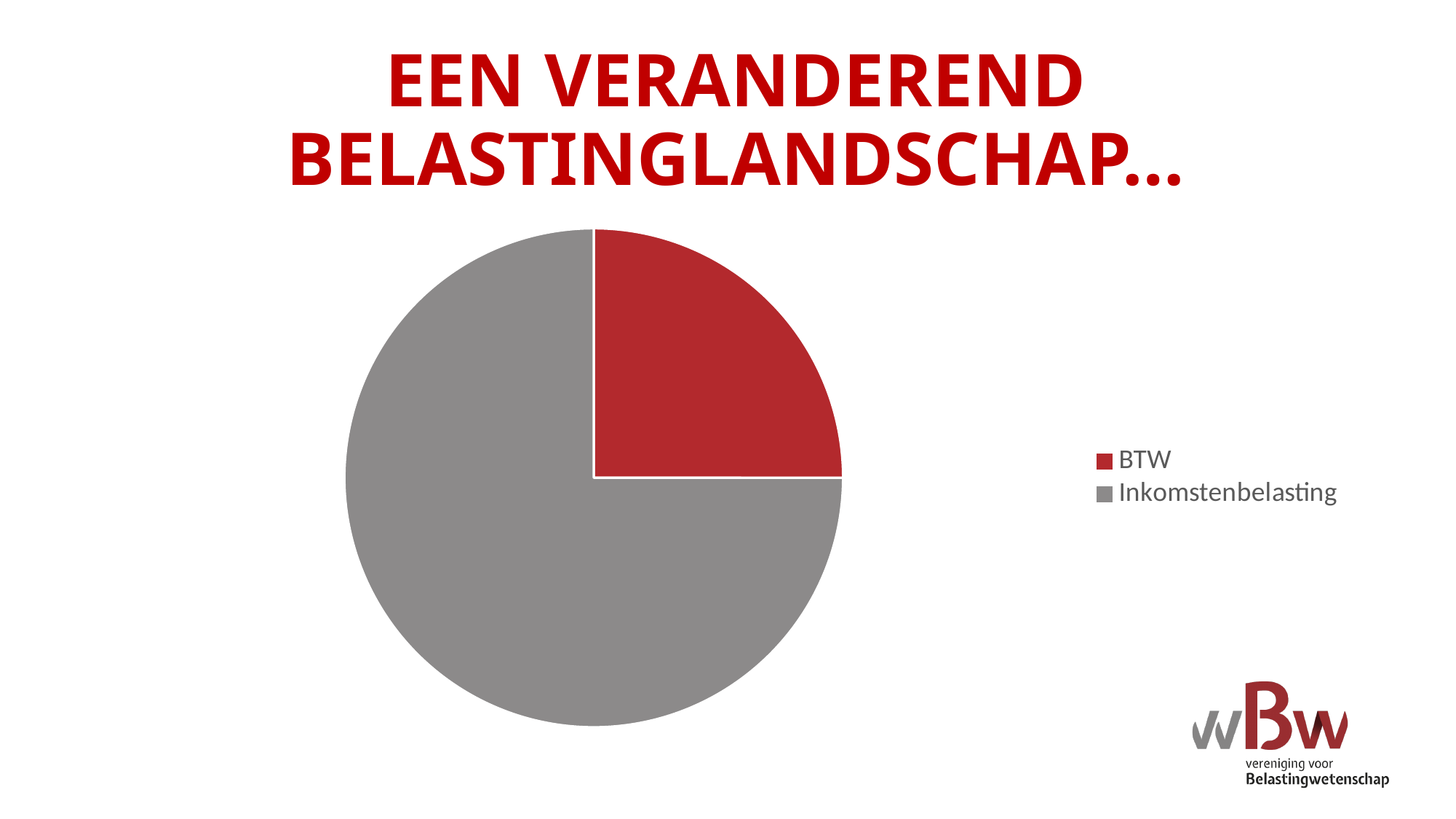
What colour is the BTW slice in the pie chart? red Which slice is larger in the pie chart, BTW or Inkomstenbelasting? Inkomstenbelasting How many entries does the legend of the pie chart list? 2 What colour is the Inkomstenbelasting slice in the pie chart? grey Which category has the smallest slice in the pie chart? BTW Which category has the largest slice in the pie chart? Inkomstenbelasting How many slices does the pie chart have? 2 What kind of chart is shown on the slide? pie chart